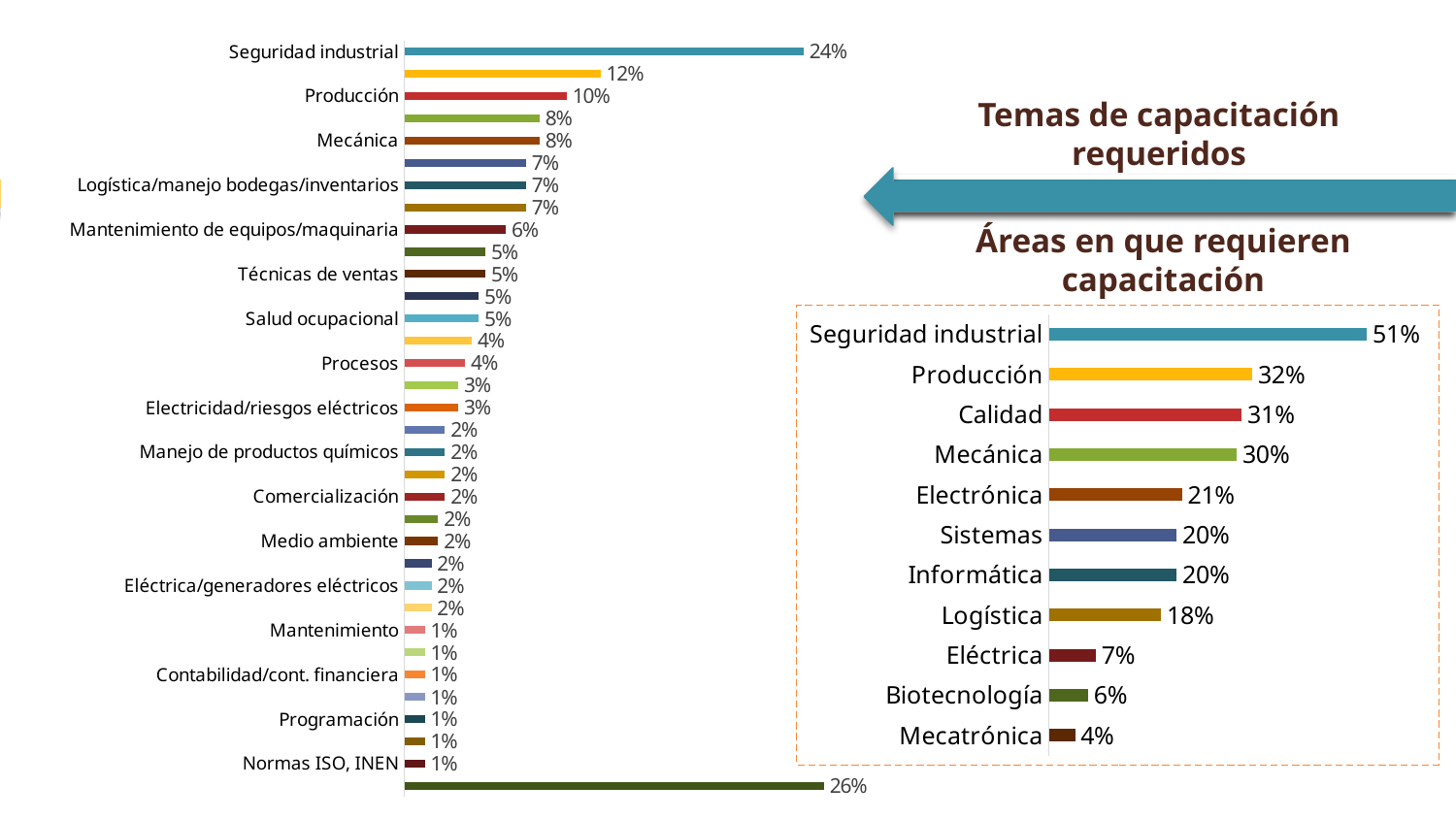
What type of chart is the 'Áreas en que requieren capacitación' chart? Bar chart In the 'Áreas en que requieren capacitación' chart, what is the value for Seguridad industrial? 51% In the 'Áreas en que requieren capacitación' chart, what is the value for Logística? 18% In the 'Áreas en que requieren capacitación' chart, which area has the lowest value? Mecatrónica In the 'Áreas en que requieren capacitación' chart, which area has the highest value? Seguridad industrial In the 'Temas de capacitación requeridos' chart, what is the value for Mantenimiento de equipos/maquinaria? 6% In the 'Temas de capacitación requeridos' chart, what is the value for Seguridad industrial? 24% In the 'Áreas en que requieren capacitación' chart, what is the difference between Producción and Calidad? 1% In the 'Temas de capacitación requeridos' chart, what is the difference between Producción and Mecánica? 2% How many areas are listed in the 'Áreas en que requieren capacitación' chart? 11 In the 'Áreas en que requieren capacitación' chart, which is larger, Electrónica or Eléctrica? Electrónica In the 'Temas de capacitación requeridos' chart, which is larger, Salud ocupacional or Procesos? Salud ocupacional